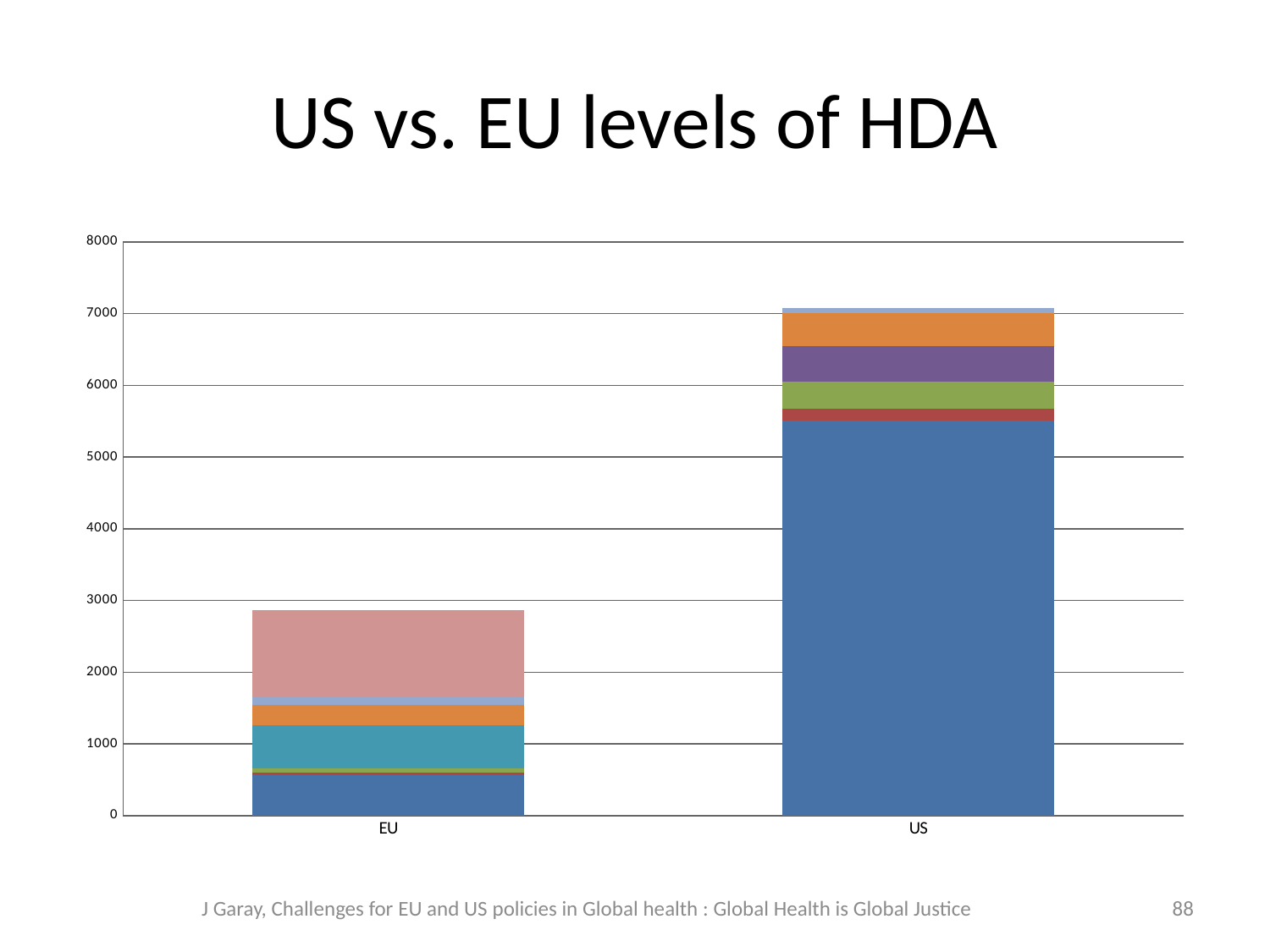
Is the total stacked bar for EU larger or smaller than the total for US? smaller What is the title of the chart? US vs. EU levels of HDA What kind of chart is shown on the slide? stacked bar chart How many categories are shown on the x axis? 2 Which category has the shorter stacked bar? EU Is the bottom (blue) segment of the US bar greater or less than 5000? greater Is the total value of the EU bar greater or less than 2000? greater Which category has the taller stacked bar? US Do the bar totals rise or fall moving from EU to US along the x axis? rise Is the total value of the US bar greater or less than 6000? greater